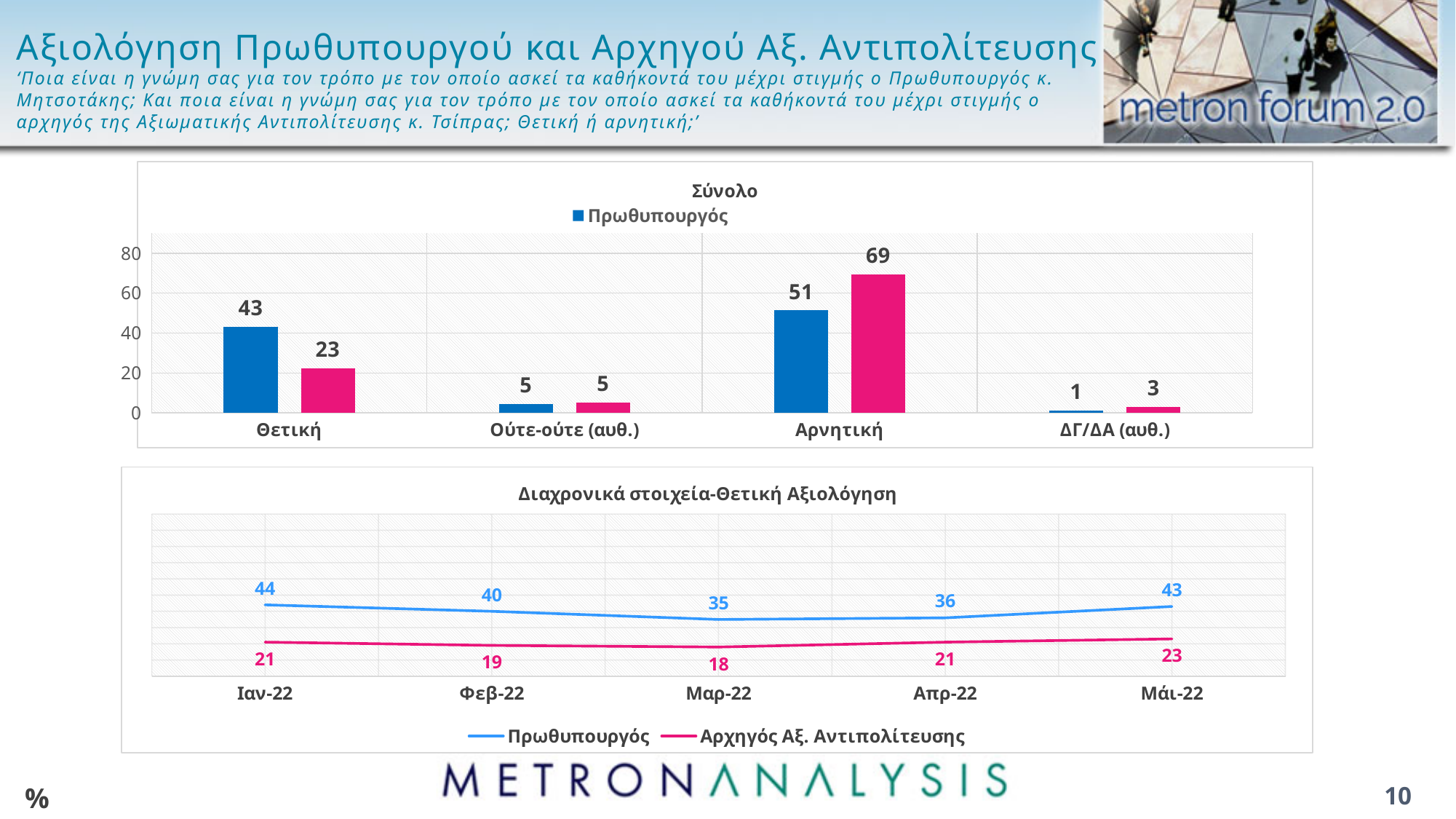
What kind of chart is the top chart titled 'Σύνολο'? Bar chart In the top chart titled 'Σύνολο', what is the value of the blue 'Πρωθυπουργός' bar for 'Θετική'? 43 In the top chart titled 'Σύνολο', how many categories are shown on the x axis? 4 In the top chart titled 'Σύνολο', which category has the highest 'Πρωθυπουργός' value? Αρνητική In the top chart titled 'Σύνολο', which category has the lowest 'Πρωθυπουργός' value? ΔΓ/ΔΑ (αυθ.) In the bottom chart titled 'Διαχρονικά στοιχεία-Θετική Αξιολόγηση', how many series does the legend list? 2 In the bottom chart titled 'Διαχρονικά στοιχεία-Θετική Αξιολόγηση', what is the 'Αρχηγός Αξ. Αντιπολίτευσης' value for Φεβ-22? 19 In the top chart titled 'Σύνολο', what is the value of the pink bar for 'Αρνητική'? 69 In the bottom chart titled 'Διαχρονικά στοιχεία-Θετική Αξιολόγηση', in which month is the 'Πρωθυπουργός' value highest? Ιαν-22 In the bottom chart titled 'Διαχρονικά στοιχεία-Θετική Αξιολόγηση', what is the difference between the 'Πρωθυπουργός' and 'Αρχηγός Αξ. Αντιπολίτευσης' values for Μάι-22? 20 In the bottom chart titled 'Διαχρονικά στοιχεία-Θετική Αξιολόγηση', what is the 'Πρωθυπουργός' value for Μαρ-22? 35 In the top chart titled 'Σύνολο', what is the difference between the blue and pink bars for 'Θετική'? 20